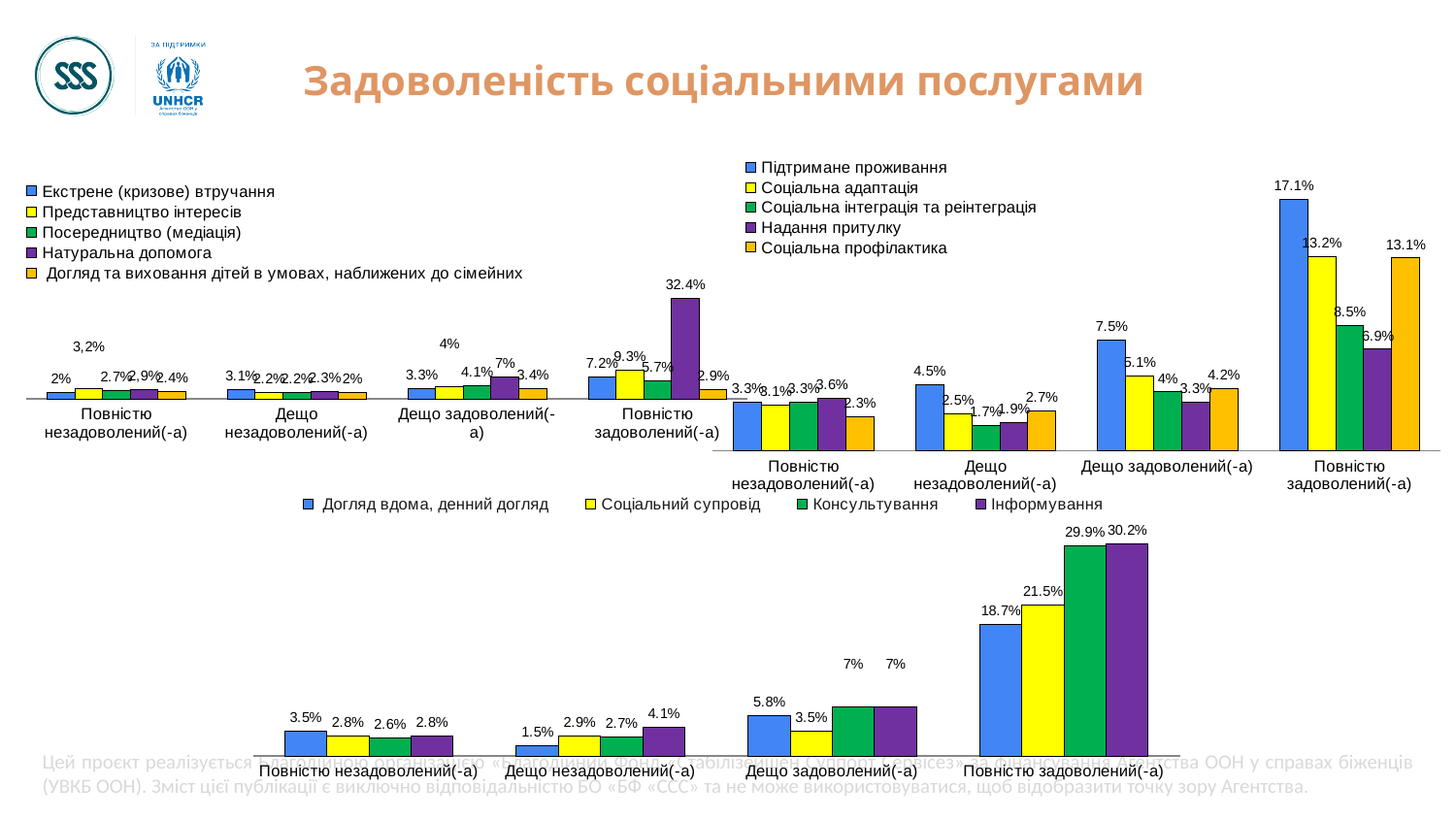
In the bottom chart, which is larger in the Повністю задоволений(-а) category: Догляд вдома, денний догляд or Соціальний супровід? Соціальний супровід In the bottom chart, what is the value for Догляд вдома, денний догляд in the Дещо незадоволений(-а) category? 1.5% In the bottom chart, how many series does the legend list? 4 In the top-left chart, how many series does the legend list? 5 What type of chart is the bottom chart? Bar chart In the top-left chart, which series has the highest value in the Повністю задоволений(-а) category? Натуральна допомога In the top-right chart, what is the difference between Підтримане проживання and Соціальна адаптація in the Повністю задоволений(-а) category? 3.9% In the top-right chart, what is the value for Підтримане проживання in the Дещо задоволений(-а) category? 7.5% In the top-left chart, what is the value for Натуральна допомога in the Повністю задоволений(-а) category? 32.4% In the top-right chart, which series has the lowest value in the Повністю задоволений(-а) category? Надання притулку In the bottom chart, what is the value for Інформування in the Повністю задоволений(-а) category? 30.2% In the top-right chart, what is the value for Підтримане проживання in the Повністю задоволений(-а) category? 17.1%